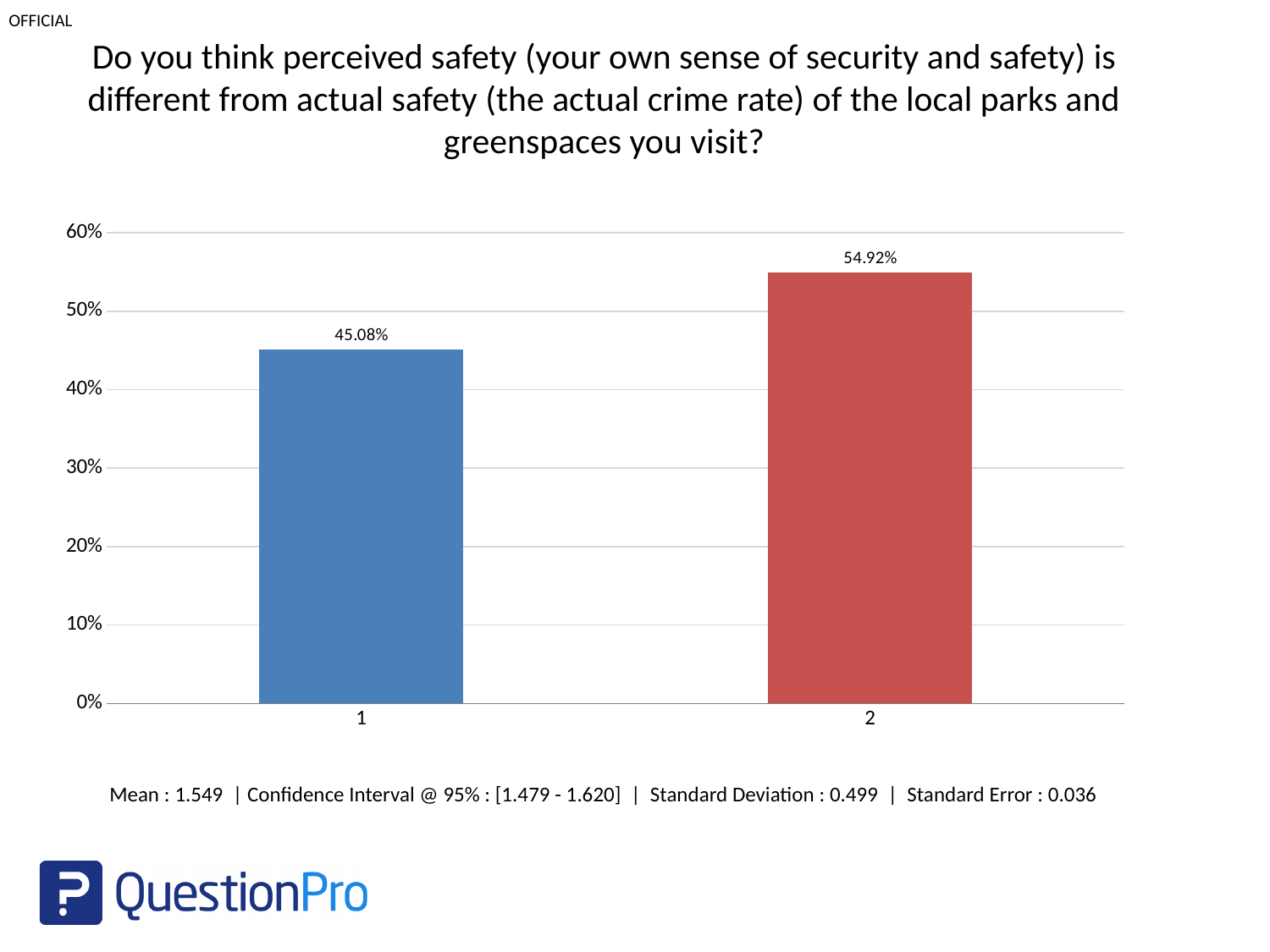
What colour is the bar for category 2? red What is the value for category 2? 54.92% What kind of chart is shown on the slide? bar chart What is the difference between the values for category 2 and category 1? 9.84% How many categories are shown on the x axis? 2 What is the mean reported below the chart? 1.549 Which category has the highest value? 2 Is the value for category 2 greater or less than 50%? greater What is the value for category 1? 45.08% Which category has the lowest value? 1 Which is larger, the value for category 1 or category 2? 2 Is the value for category 1 greater or less than 50%? less